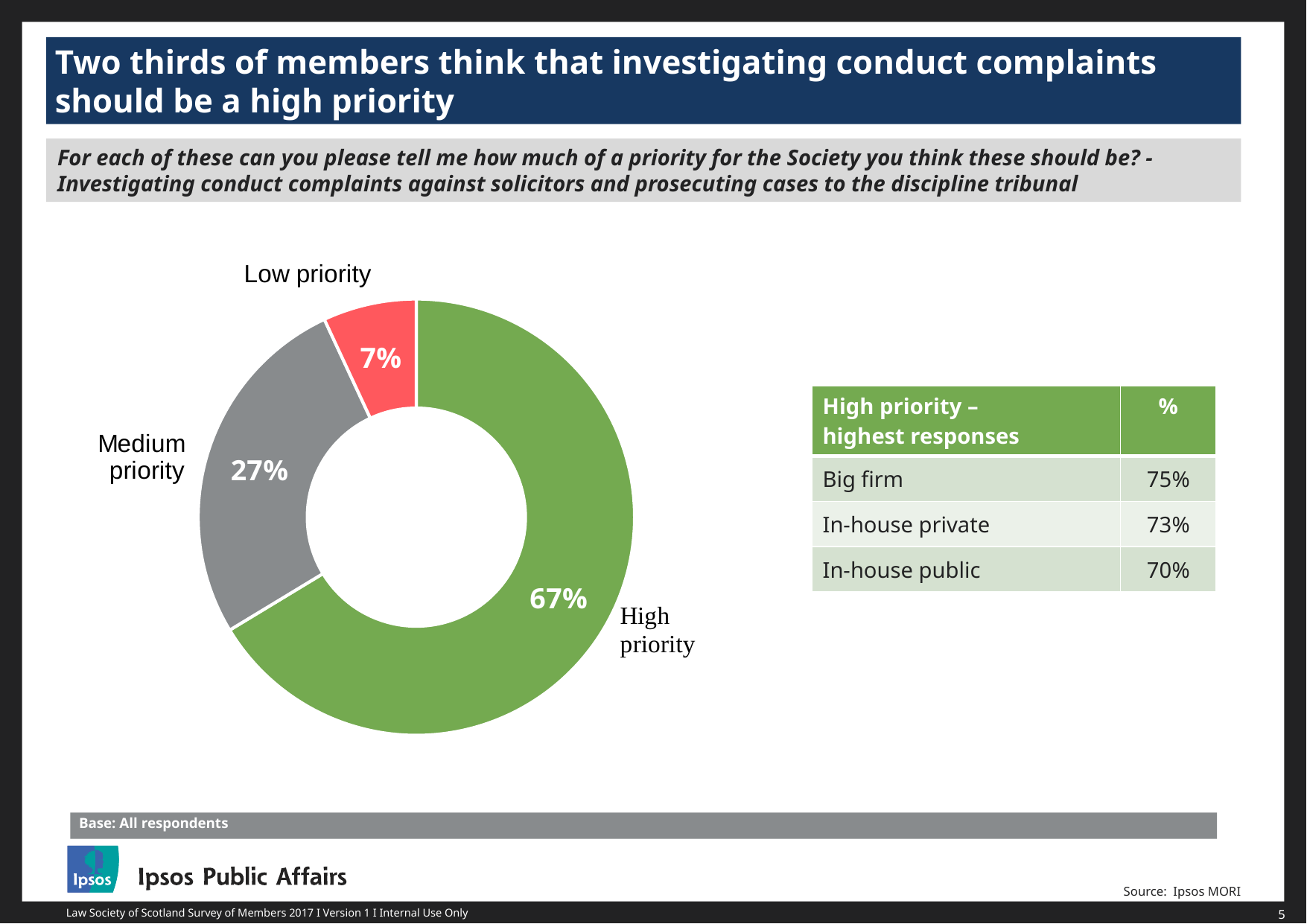
What is the difference in percentage points between the medium priority and low priority shares? 20 Which priority level has the smallest share of the chart? Low priority What percentage of members said investigating conduct complaints should be a low priority? 7% What is the difference in percentage points between the high priority and medium priority shares? 40 What percentage of members said investigating conduct complaints should be a medium priority? 27% Which is larger, the medium priority share or the low priority share? Medium priority Which priority level has the largest share of the chart? High priority How many segments does the chart have? 3 What colour is the low priority segment of the chart? Red What percentage of members said investigating conduct complaints should be a high priority? 67% What kind of chart is shown on the slide? Doughnut (pie) chart What colour is the high priority segment of the chart? Green